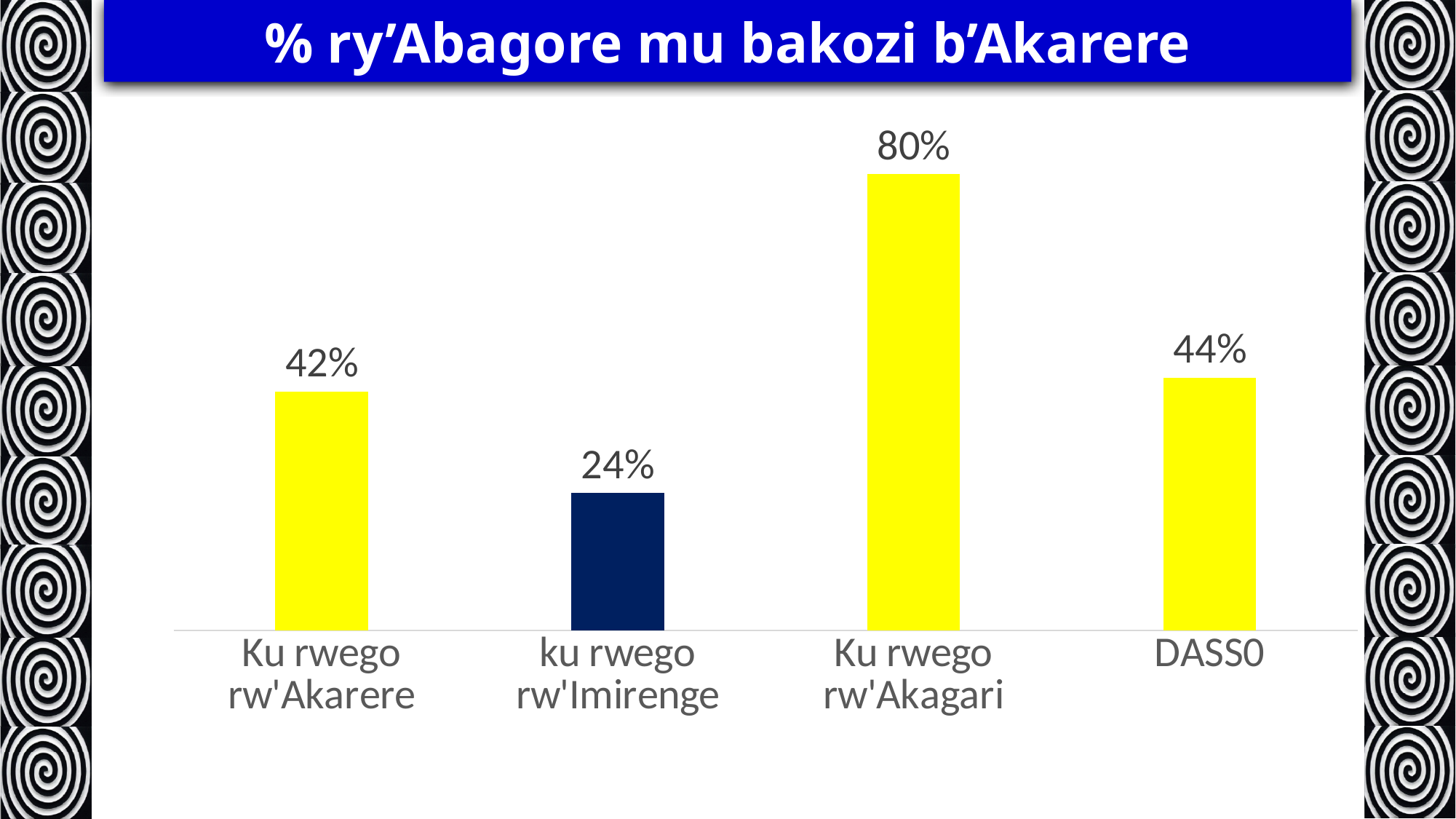
Which category has the lowest value? ku rwego rw'Imirenge What is the value for Ku rwego rw'Akagari? 80% What kind of chart is shown on the slide? Bar chart What is the value for ku rwego rw'Imirenge? 24% What is the value for DASS0? 44% What is the value for Ku rwego rw'Akarere? 42% What is the title of the chart? % ry'Abagore mu bakozi b'Akarere Which category has the highest value? Ku rwego rw'Akagari Which is larger, the value for Ku rwego rw'Akarere or the value for ku rwego rw'Imirenge? Ku rwego rw'Akarere How many categories are shown in the chart? 4 What is the difference between the values for DASS0 and Ku rwego rw'Akarere? 2% What is the difference between the values for Ku rwego rw'Akagari and ku rwego rw'Imirenge? 56%